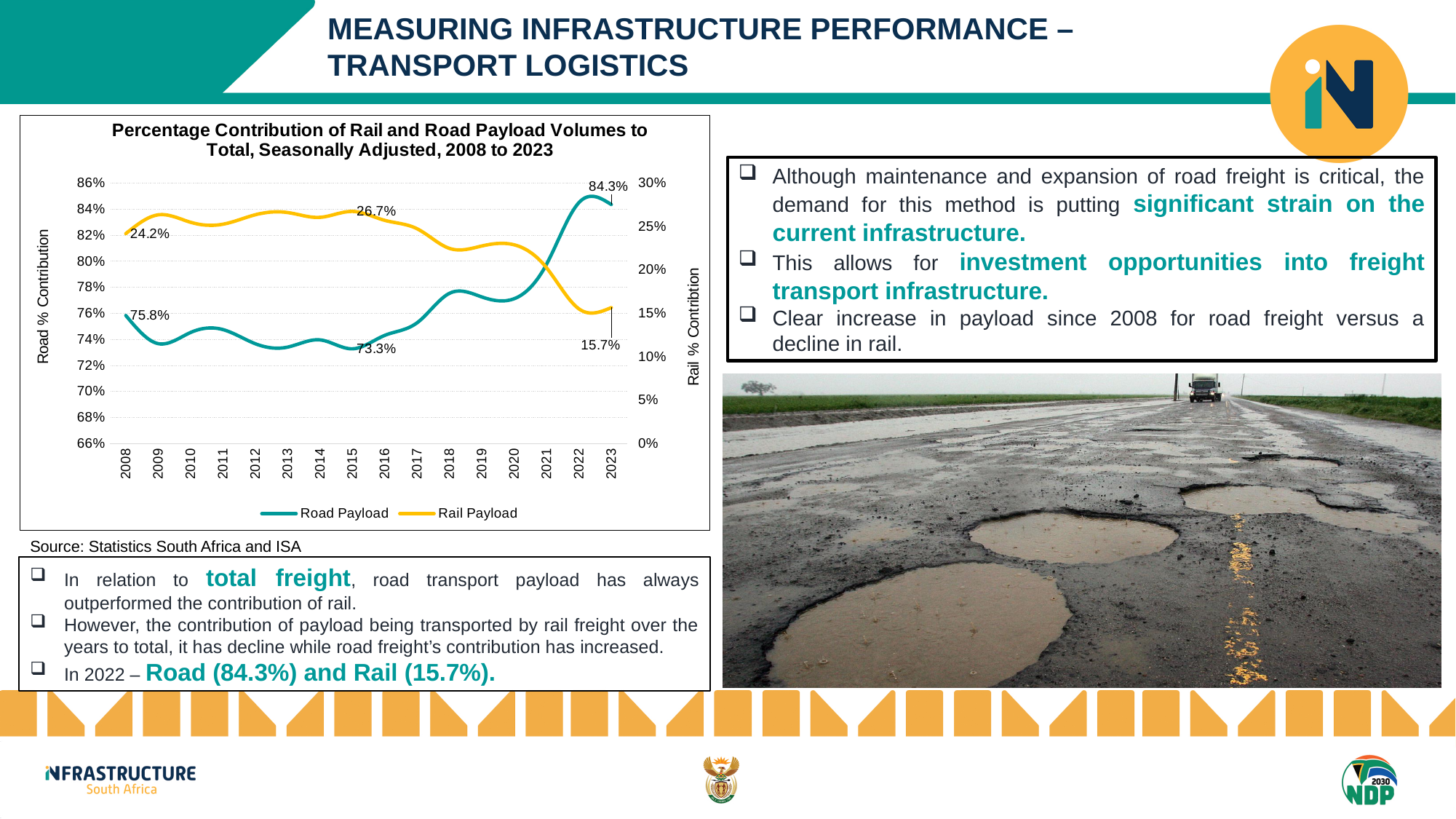
What was the Rail Payload contribution in 2022? 15.7% What was the Road Payload contribution in 2015? 73.3% What was the Rail Payload contribution in 2008? 24.2% By how many percentage points did the Rail Payload contribution fall from 2008 to 2022? 8.5 percentage points What kind of chart is shown on the slide? line chart Does the Rail Payload line overall rise or fall from 2008 to 2023? fall How many series does the chart legend list? 2 By how many percentage points did the Road Payload contribution increase from 2008 to 2022? 8.5 percentage points How many years are shown on the x axis of the chart? 16 What was the Road Payload contribution in 2022? 84.3% What was the Rail Payload contribution in 2015? 26.7% What was the Road Payload contribution in 2008? 75.8%